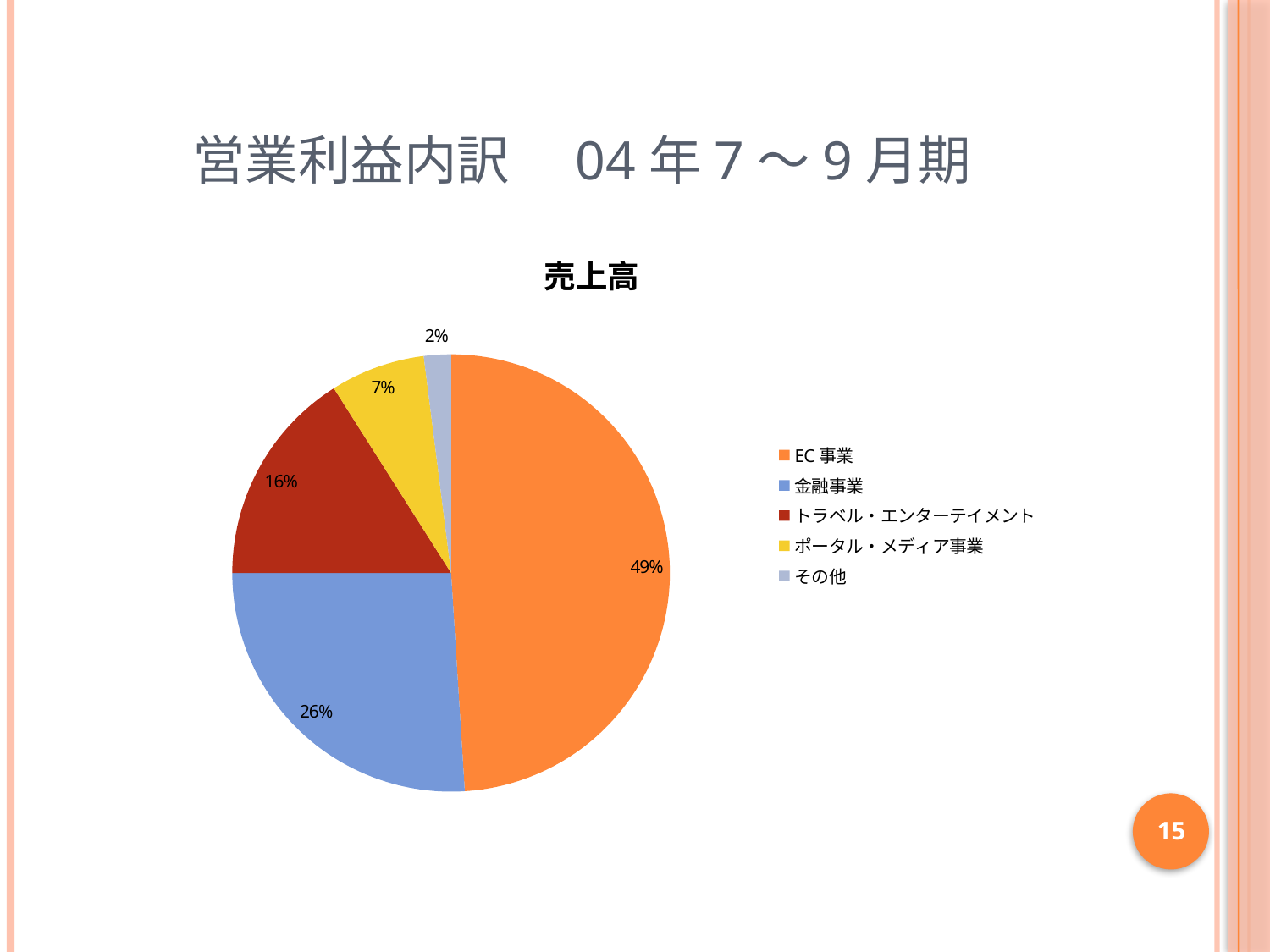
What is the difference in percentage points between EC 事業 and 金融事業? 23 Which is larger, the slice for トラベル・エンターテイメント or the slice for ポータル・メディア事業? トラベル・エンターテイメント What share of the pie does その他 hold? 2% What is the title of the chart? 売上高 Which category has the largest slice of the pie? EC 事業 What share of the pie does トラベル・エンターテイメント hold? 16% What share of the pie does ポータル・メディア事業 hold? 7% How many categories are shown in the pie chart? 5 Which category has the smallest slice of the pie? その他 What kind of chart is shown on the slide? Pie chart